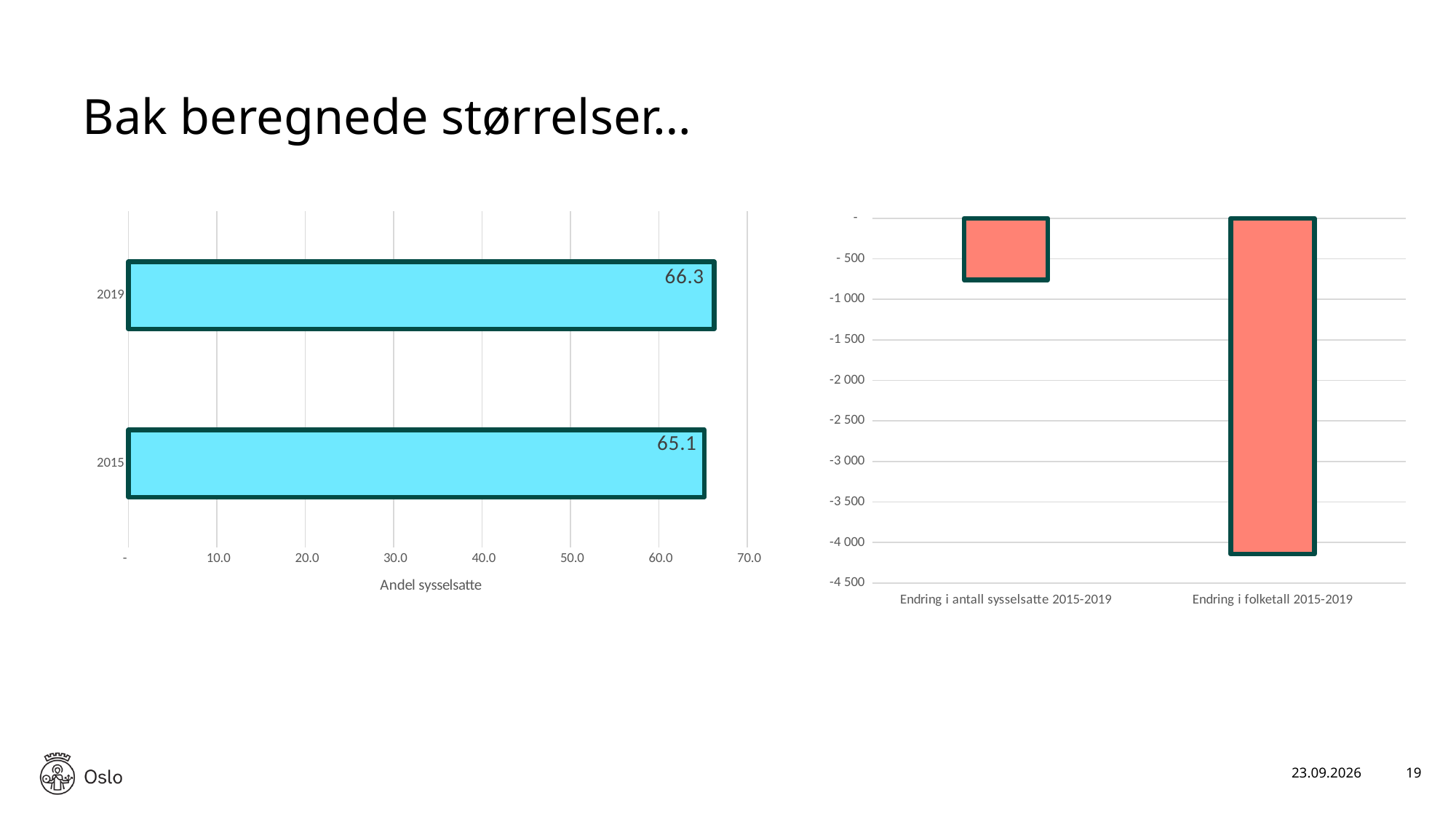
In the left chart (Andel sysselsatte), which year has the higher value? 2019 In the left chart (Andel sysselsatte), how many bars are plotted? 2 In the left chart (Andel sysselsatte), which year has the lower value? 2015 In the right chart, which category has the lowest (most negative) value? Endring i folketall 2015-2019 In the right chart, how many categories are shown on the x axis? 2 In the left chart (Andel sysselsatte), what is the value for 2019? 66.3 In the left chart (Andel sysselsatte), what is the value for 2015? 65.1 In the right chart, is the value for 'Endring i antall sysselsatte 2015-2019' greater or less than -500? less In the left chart (Andel sysselsatte), is the value for 2015 greater or less than 60.0? greater In the left chart (Andel sysselsatte), what is the difference between the 2019 and 2015 values? 1.2 What kind of chart is the left chart (Andel sysselsatte)? Bar chart In the right chart, is the value for 'Endring i folketall 2015-2019' greater or less than -4 000? less